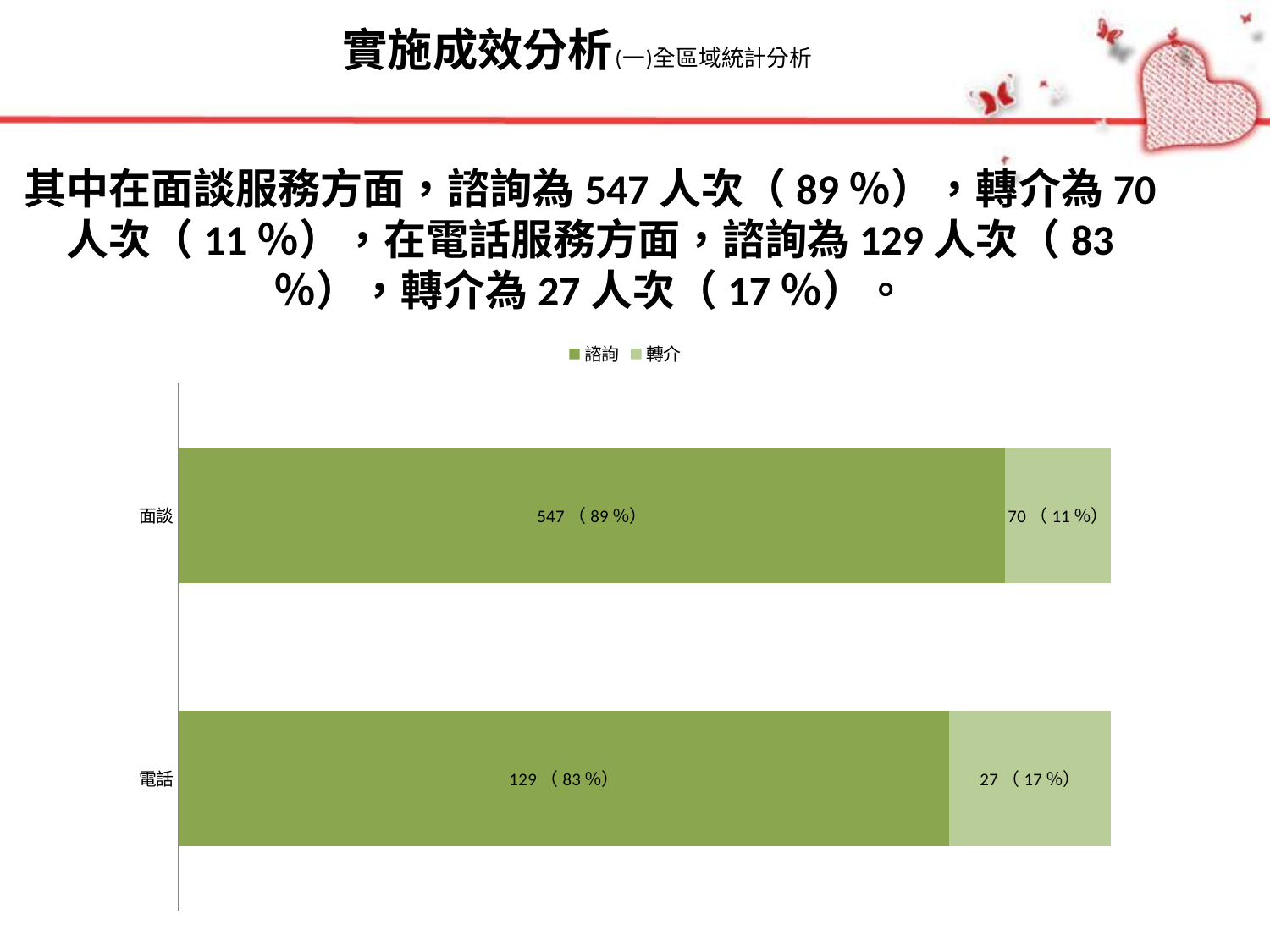
What is the 諮詢 value for 面談? 547 (89%) What is the 轉介 value for 電話? 27 (17%) What are the two series named in the chart legend? 諮詢 and 轉介 How many series does the chart legend list? 2 What is the total count (諮詢 plus 轉介) for the 面談 bar? 617 What is the difference between the 諮詢 counts for 面談 and 電話? 418 How many categories are plotted on the chart? 2 What is the total count (諮詢 plus 轉介) for the 電話 bar? 156 What is the 轉介 value for 面談? 70 (11%) Which category has the higher 諮詢 count, 面談 or 電話? 面談 What kind of chart is shown on the slide? bar chart What is the 諮詢 value for 電話? 129 (83%)